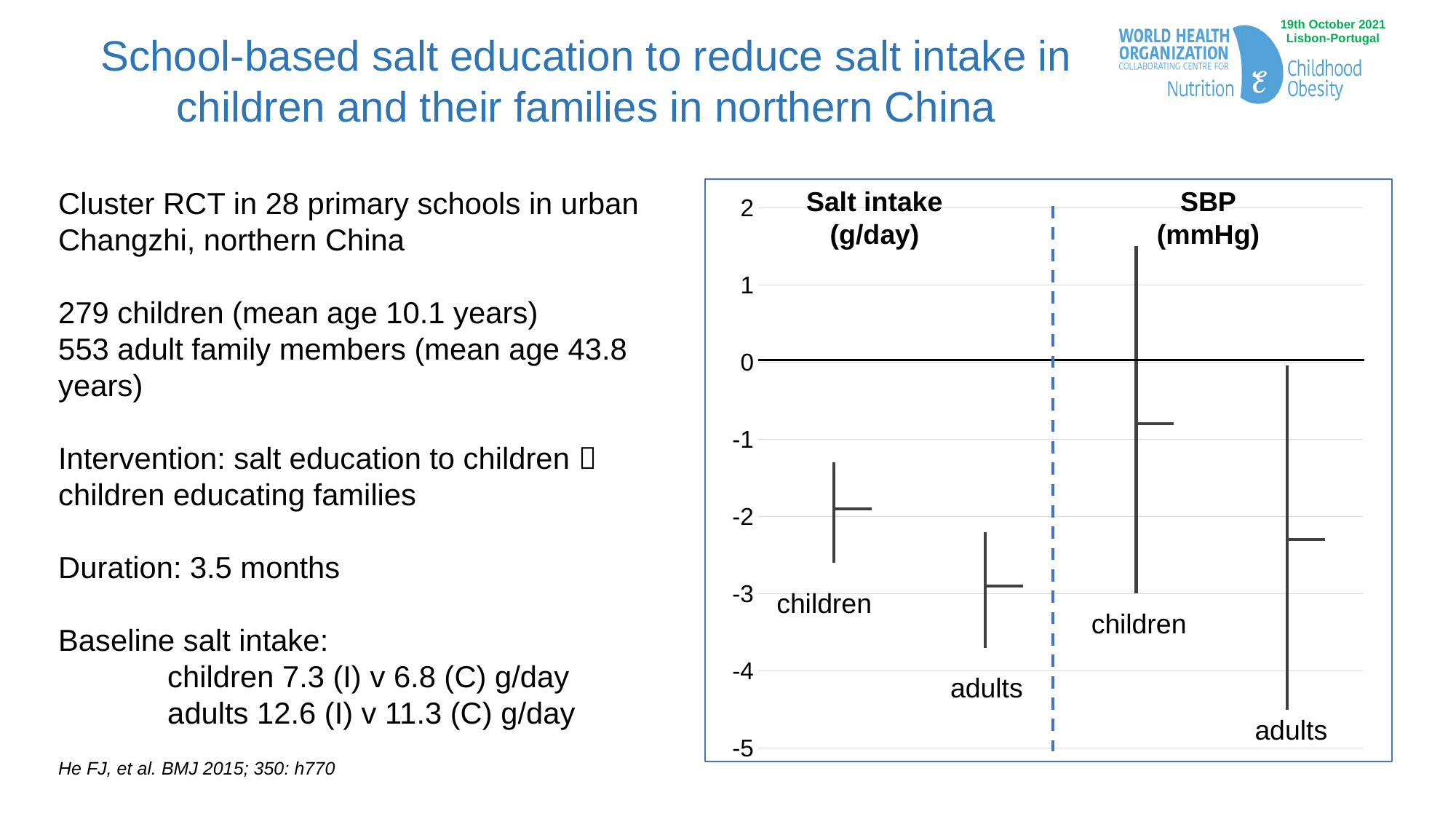
Is the point estimate for SBP change in adults greater or less than -3? greater How many groups are shown in the SBP panel of the chart? 2 Is the point estimate for salt intake change in children greater or less than -1? less Is the point estimate for SBP change in adults greater or less than -2? less What unit is used for the SBP panel of the chart? mmHg In the salt intake panel, which group has the larger reduction (more negative point estimate), children or adults? adults What is the lowest value shown on the chart's vertical axis? -5 How many point estimates with confidence intervals are plotted on the chart in total? 4 What kind of chart is shown on the slide? error bar chart (point estimates with confidence intervals) In the SBP panel, which group has the larger reduction (more negative point estimate), children or adults? adults